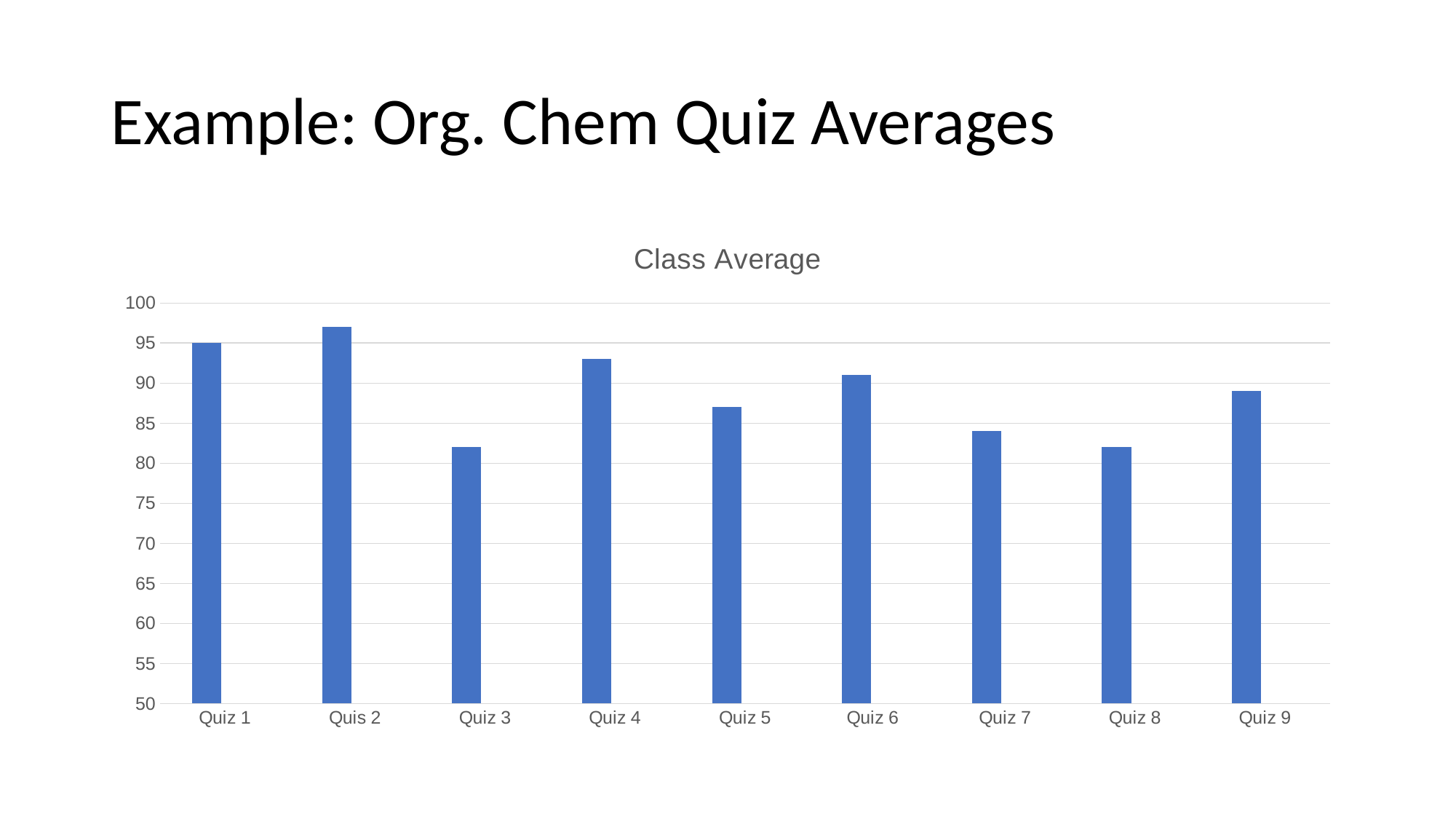
What kind of chart is shown on the slide? bar chart Is the value for Quiz 5 greater or less than 90? less Which is larger, the value for Quiz 4 or the value for Quiz 5? Quiz 4 Is the value for Quiz 9 greater or less than 85? greater What is the value for Quiz 1? 95 Is the value for Quiz 6 greater or less than 90? greater What is the title of the chart? Class Average How many quizzes are shown on the chart? 9 Which is larger, the value for Quiz 7 or the value for Quiz 6? Quiz 6 Which quiz has the highest class average? Quis 2